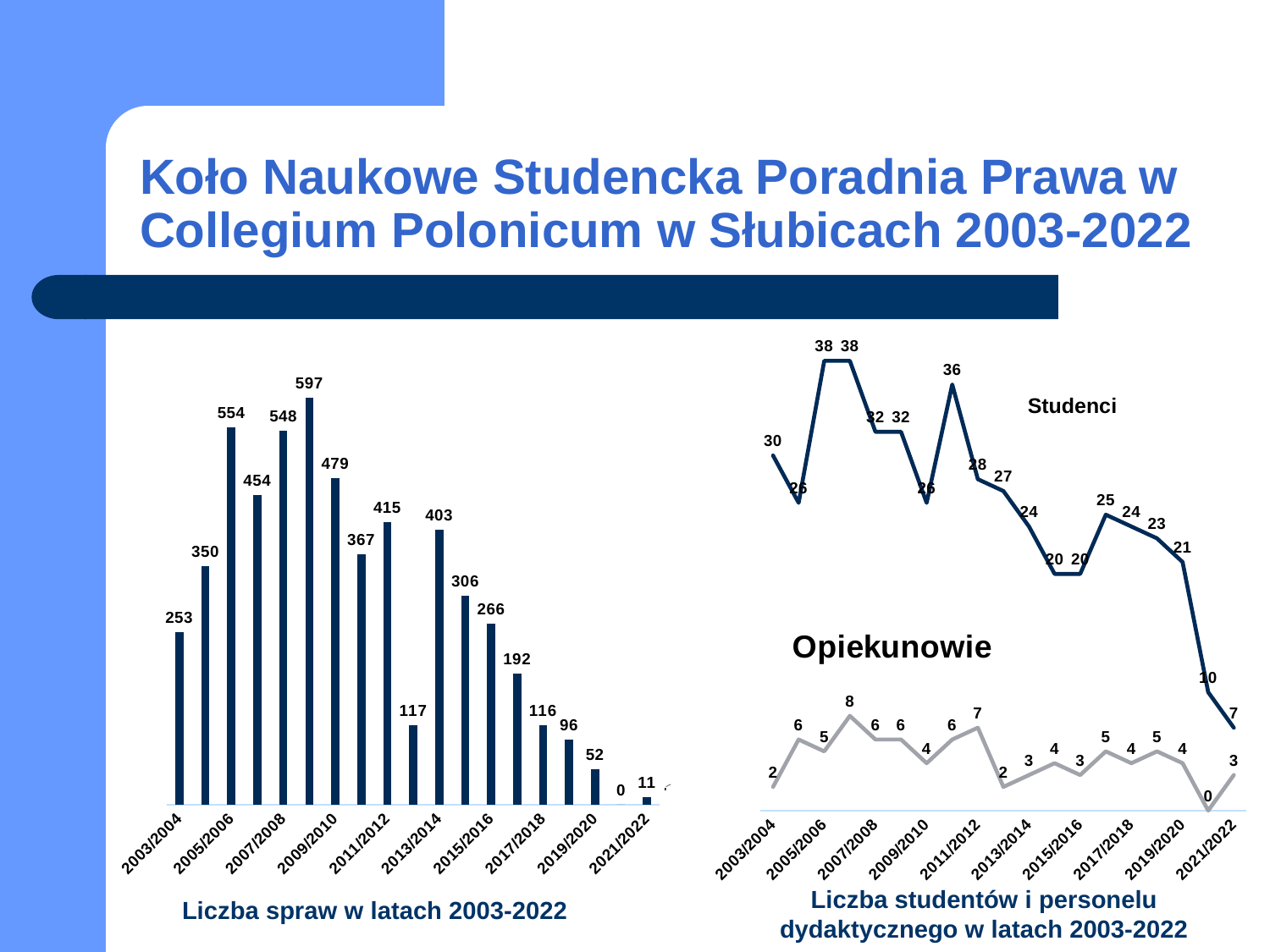
In the chart 'Liczba spraw w latach 2003-2022', what is the value for 2003/2004? 253 How many series are shown in the chart 'Liczba studentów i personelu dydaktycznego w latach 2003-2022'? 2 In the chart 'Liczba spraw w latach 2003-2022', what is the difference between the values for 2005/2006 and 2007/2008? 6 In the chart 'Liczba spraw w latach 2003-2022', what is the lowest value shown? 0 In the chart 'Liczba spraw w latach 2003-2022', what is the value for 2021/2022? 11 What kind of chart is 'Liczba spraw w latach 2003-2022'? bar chart In the chart 'Liczba studentów i personelu dydaktycznego w latach 2003-2022', which is larger for Studenci: 2003/2004 or 2021/2022? 2003/2004 How many bars are in the chart 'Liczba spraw w latach 2003-2022'? 19 In the chart 'Liczba studentów i personelu dydaktycznego w latach 2003-2022', what is the Opiekunowie value for 2007/2008? 6 In the chart 'Liczba spraw w latach 2003-2022', what is the highest value shown? 597 In the chart 'Liczba studentów i personelu dydaktycznego w latach 2003-2022', what is the Studenci value for 2011/2012? 28 In the chart 'Liczba studentów i personelu dydaktycznego w latach 2003-2022', what is the highest Studenci value? 38